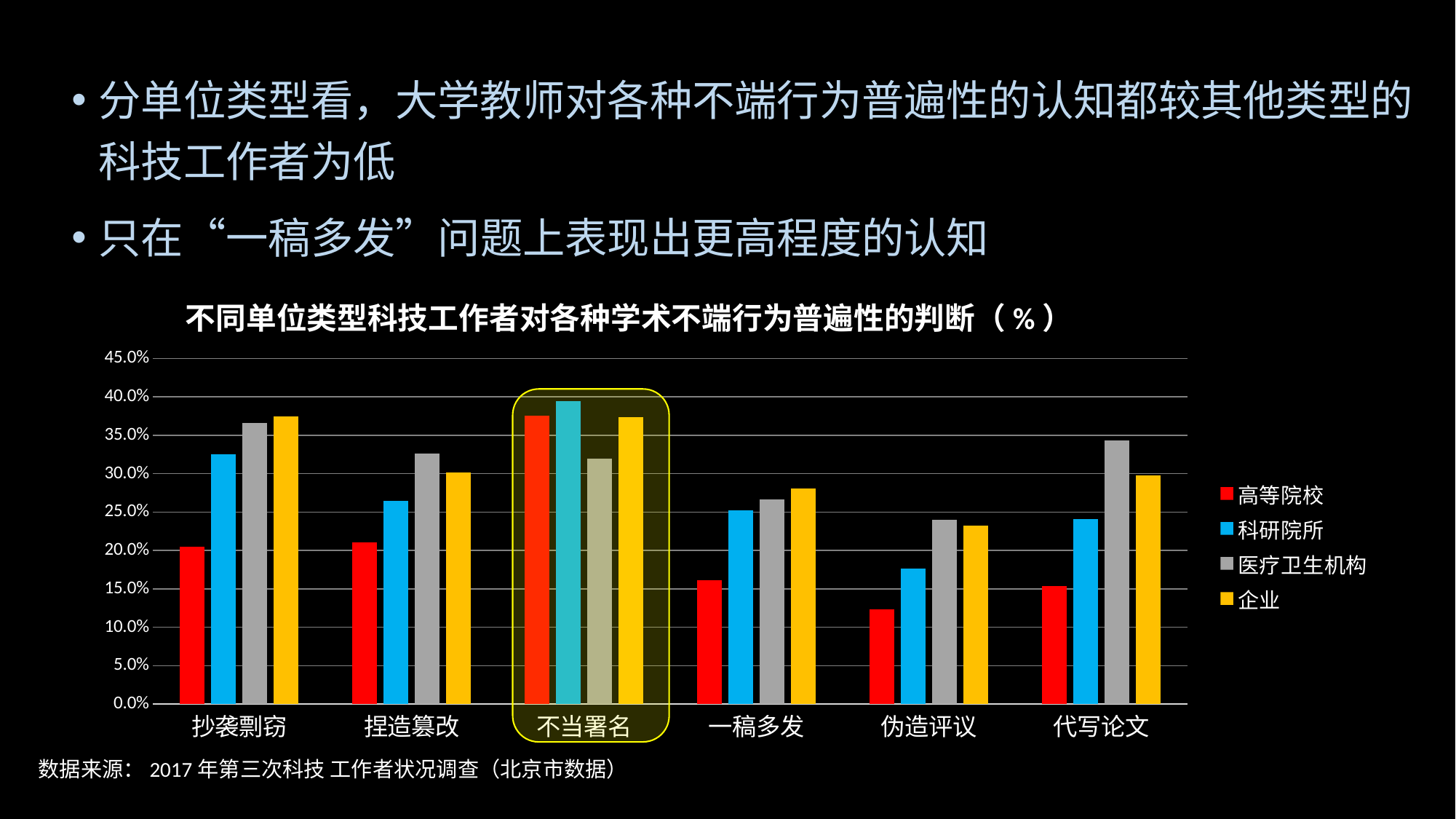
Is the value for 科研院所 in 不当署名 greater or less than 35.0%? greater Is the value for 高等院校 in 抄袭剽窃 greater or less than 25.0%? less Which category on the x axis is highlighted with a yellow box? 不当署名 In 代写论文, which is larger: 医疗卫生机构 or 企业? 医疗卫生机构 How many categories are shown on the x axis? 6 For which category is the 高等院校 bar the lowest? 伪造评议 What kind of chart is shown on the slide? bar chart In 一稿多发, which is larger: 高等院校 or 科研院所? 科研院所 How many series does the legend list? 4 For which category is the 高等院校 bar the highest? 不当署名 Is the value for 企业 in 一稿多发 greater or less than 25.0%? greater Which series has the highest value in 代写论文? 医疗卫生机构